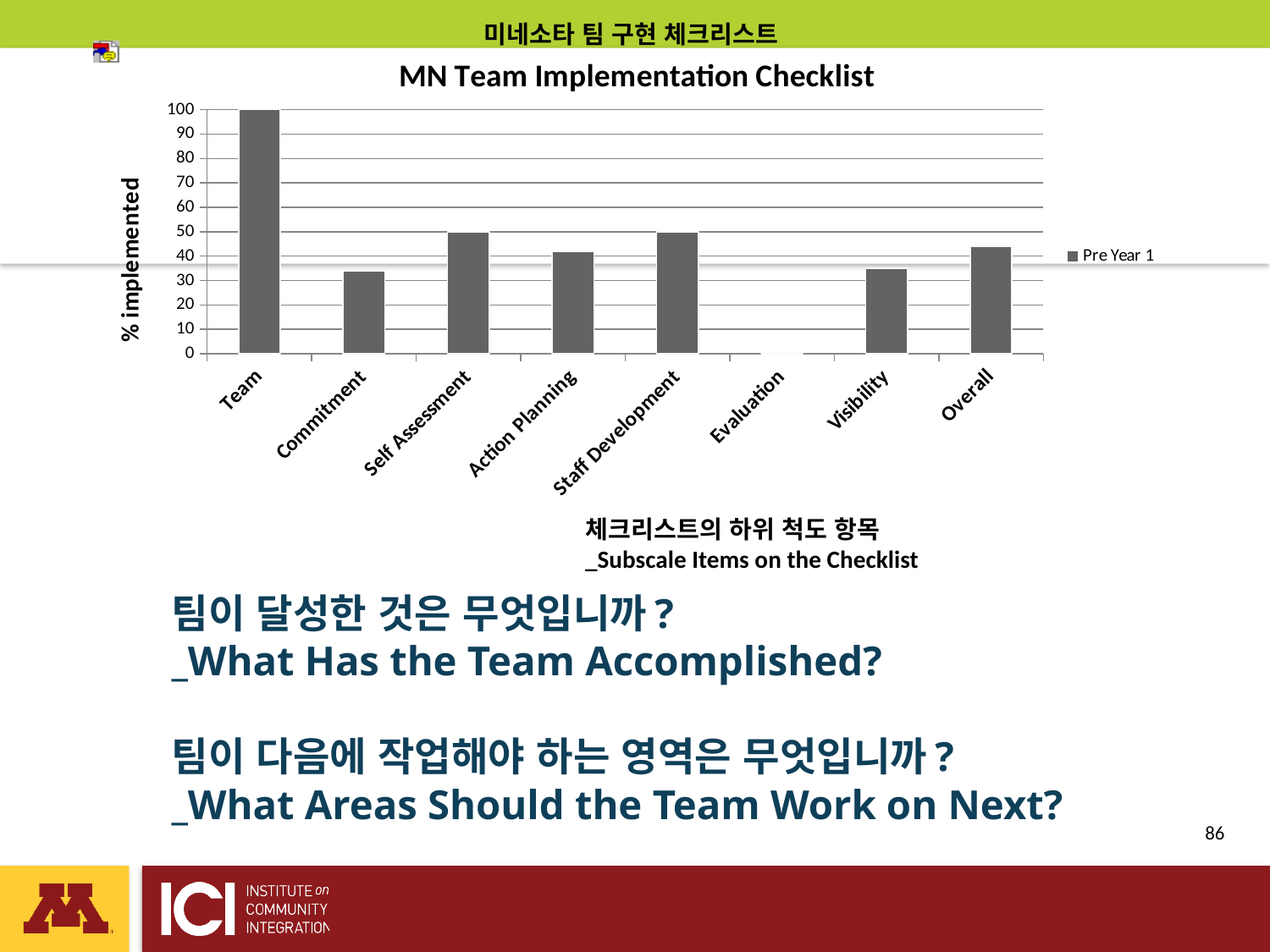
Is the value for Commitment greater or less than 40? less What kind of chart is shown on the slide? bar chart How many categories are shown on the x axis of the MN Team Implementation Checklist chart? 8 How many series does the legend of the chart list? 1 Is the value for Overall greater or less than 40? greater Which category has the highest % implemented? Team What is the legend entry shown for the series in the chart? Pre Year 1 What is the % implemented value for Team? 100 What is the % implemented value for Evaluation? 0 Is the value for Visibility greater or less than 40? less Which category has the lowest % implemented? Evaluation Which is larger, the value for Action Planning or the value for Visibility? Action Planning